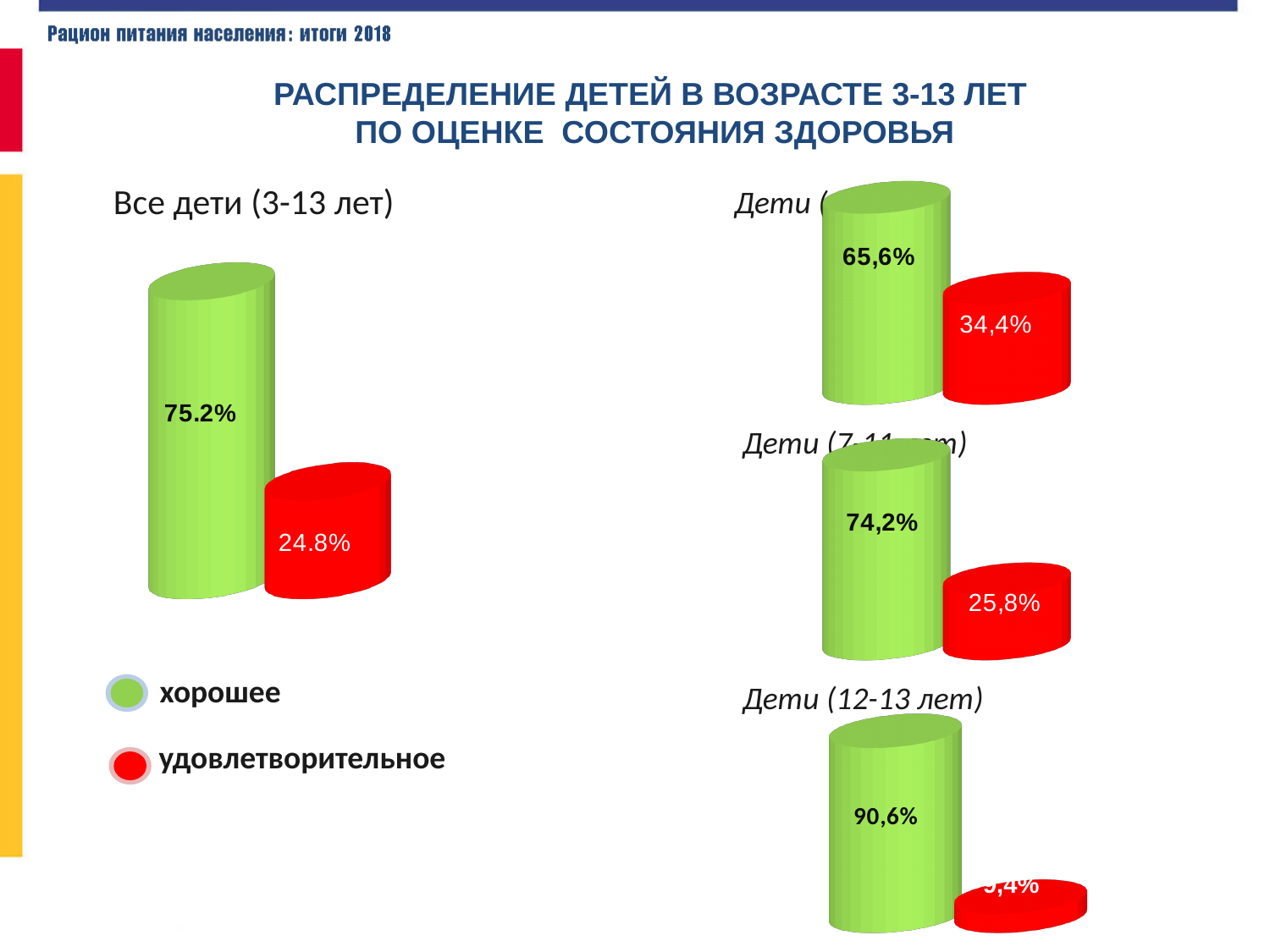
In the top right chart, what is the value for the red (удовлетворительное) bar? 34,4% Which colour represents удовлетворительное in the legend? red In the chart titled "Дети (12-13 лет)", what is the value for хорошее? 90,6% What kind of chart is used for "Все дети (3-13 лет)"? bar chart In the chart titled "Все дети (3-13 лет)", what is the value for удовлетворительное? 24.8% In the chart titled "Дети (7-11 лет)", what is the value for хорошее? 74,2% In the chart titled "Дети (7-11 лет)", what is the value for удовлетворительное? 25,8% In the chart titled "Все дети (3-13 лет)", what is the value for хорошее? 75.2% In the top right chart, what is the value for the green (хорошее) bar? 65,6% In the top right chart, which category has the lowest value? удовлетворительное In the chart titled "Дети (7-11 лет)", which category has the higher value, хорошее or удовлетворительное? хорошее In the chart titled "Все дети (3-13 лет)", what is the difference between the хорошее and удовлетворительное values? 50.4%